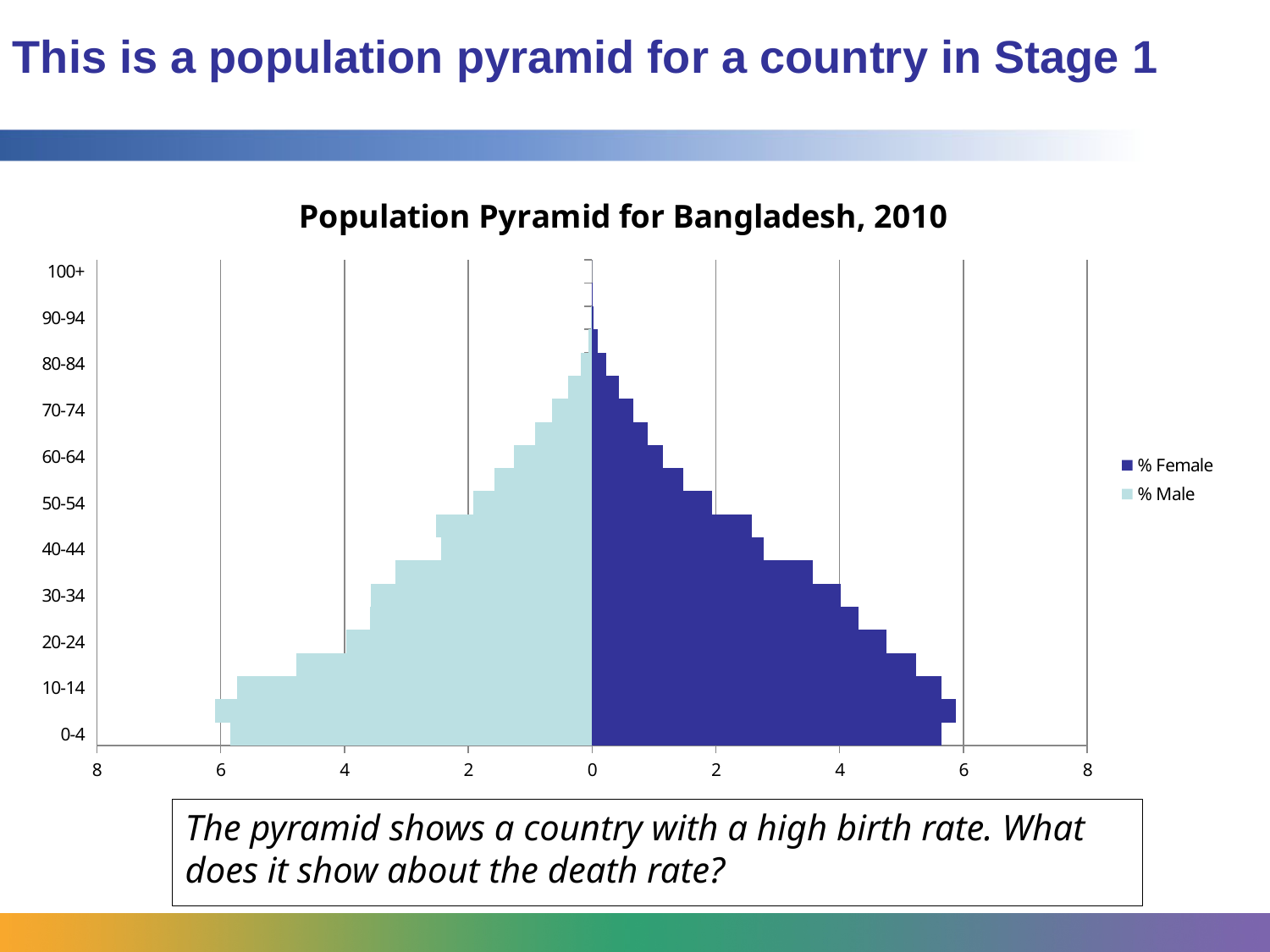
How many series does the legend list? 2 Do the bar lengths generally rise or fall as the age groups get older? fall Is the % Female value for the 40-44 age group greater or less than 4? less What is the title of the chart? Population Pyramid for Bangladesh, 2010 What kind of chart is shown on the slide? Bar chart (population pyramid) Is the % Female value for the 0-4 age group greater or less than 6? less For the 20-24 age group, which is larger: % Male or % Female? % Female Is the % Female value for the 20-24 age group greater or less than 4? greater Which series is shown in dark blue? % Female